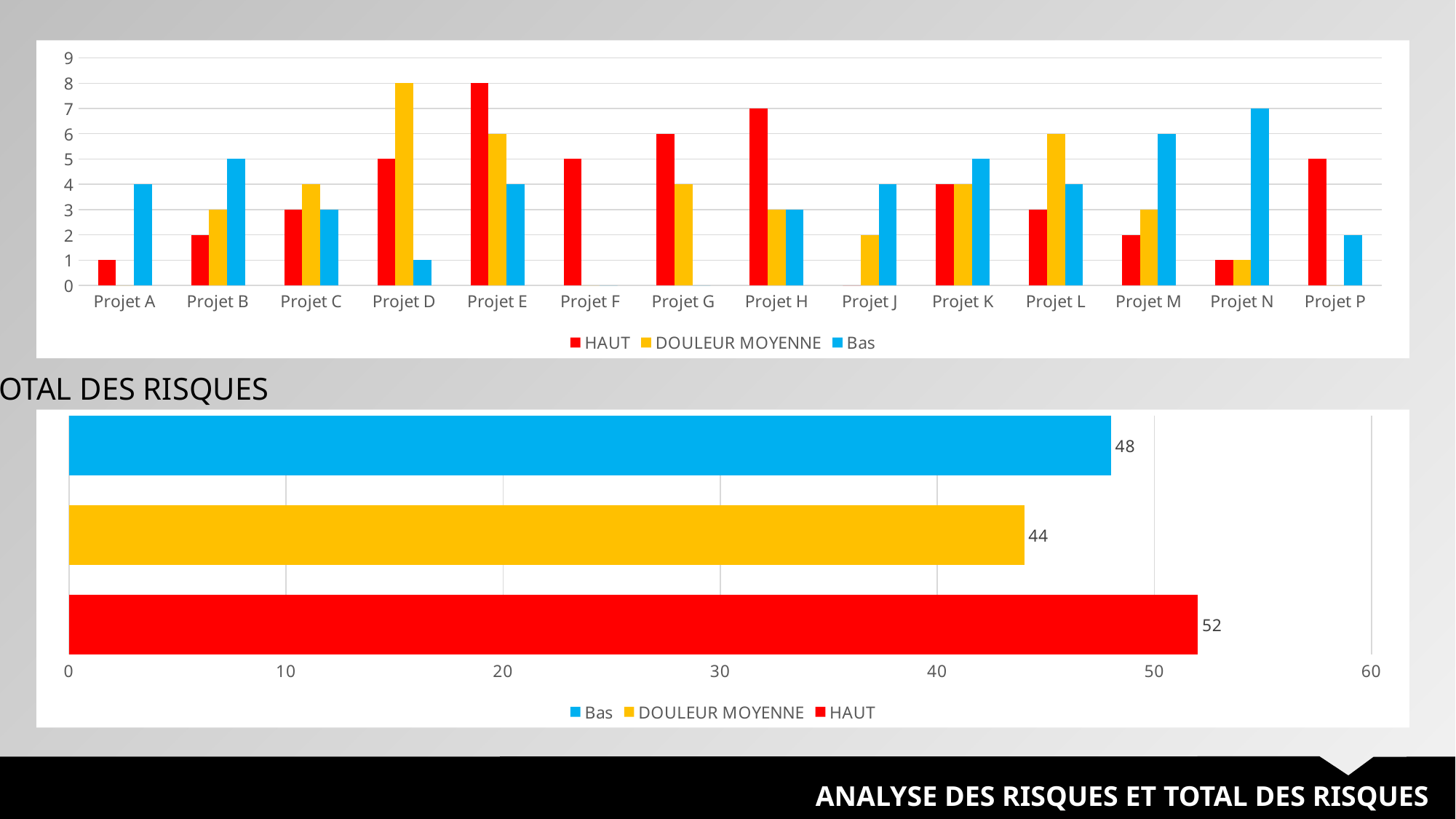
In the top chart, what is the HAUT value for Projet E? 8 In the bottom chart, which category has the lowest value? DOULEUR MOYENNE What kind of chart is the bottom chart? Bar chart In the bottom chart, what is the difference between the HAUT value and the Bas value? 4 In the top chart, which project has the highest Bas value? Projet N In the bottom chart, what is the value for HAUT? 52 In the bottom chart, which category has the highest value? HAUT In the top chart, how many series does the legend list? 3 In the bottom chart, which is larger, Bas or DOULEUR MOYENNE? Bas In the top chart, how many projects are shown on the x axis? 14 In the top chart, which colour represents the DOULEUR MOYENNE series? Yellow In the bottom chart, what is the value for DOULEUR MOYENNE? 44